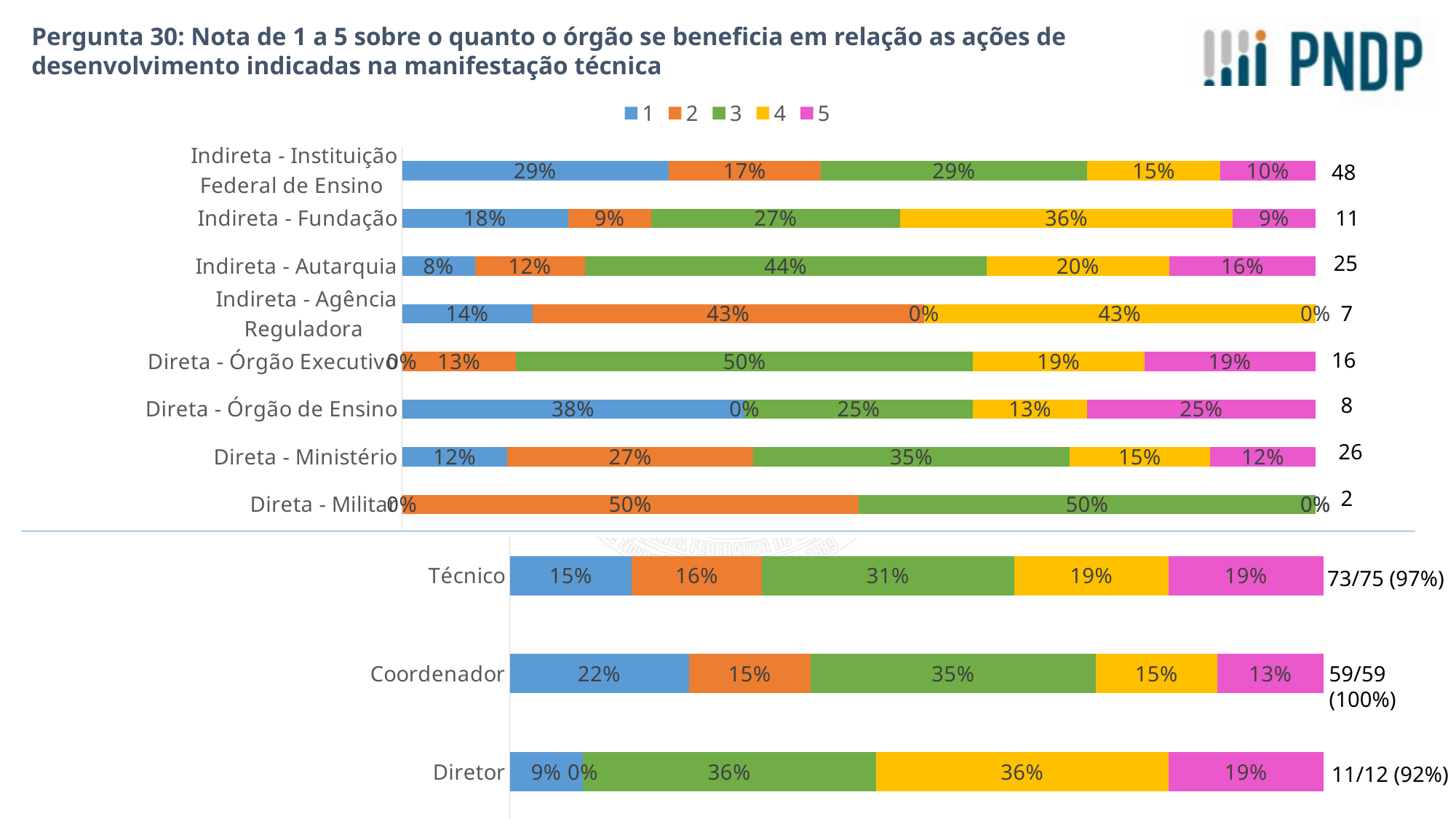
In the top chart, what percentage of Indireta - Fundação respondents gave a score of 4? 36% In the top chart, what percentage of Indireta - Autarquia respondents gave a score of 3? 44% In the bottom chart, which role has the lowest percentage for score 1? Diretor In the top chart, what number is shown at the end of the Direta - Ministério bar? 26 In the bottom chart, which is larger: the score-3 percentage for Coordenador or for Técnico? Coordenador In the bottom chart, what is the response count label shown next to the Técnico bar? 73/75 (97%) What type of chart is used on this slide? Stacked bar chart In the top chart, which category has the highest percentage for score 3? Direta - Militar and Direta - Órgão Executivo (both 50%) In the top chart, what is the difference between the score-2 percentages of Indireta - Agência Reguladora and Direta - Ministério? 16% In the bottom chart, what percentage of Coordenador respondents gave a score of 1? 22% How many series does the legend list? 5 How many categories are shown in the top chart? 8